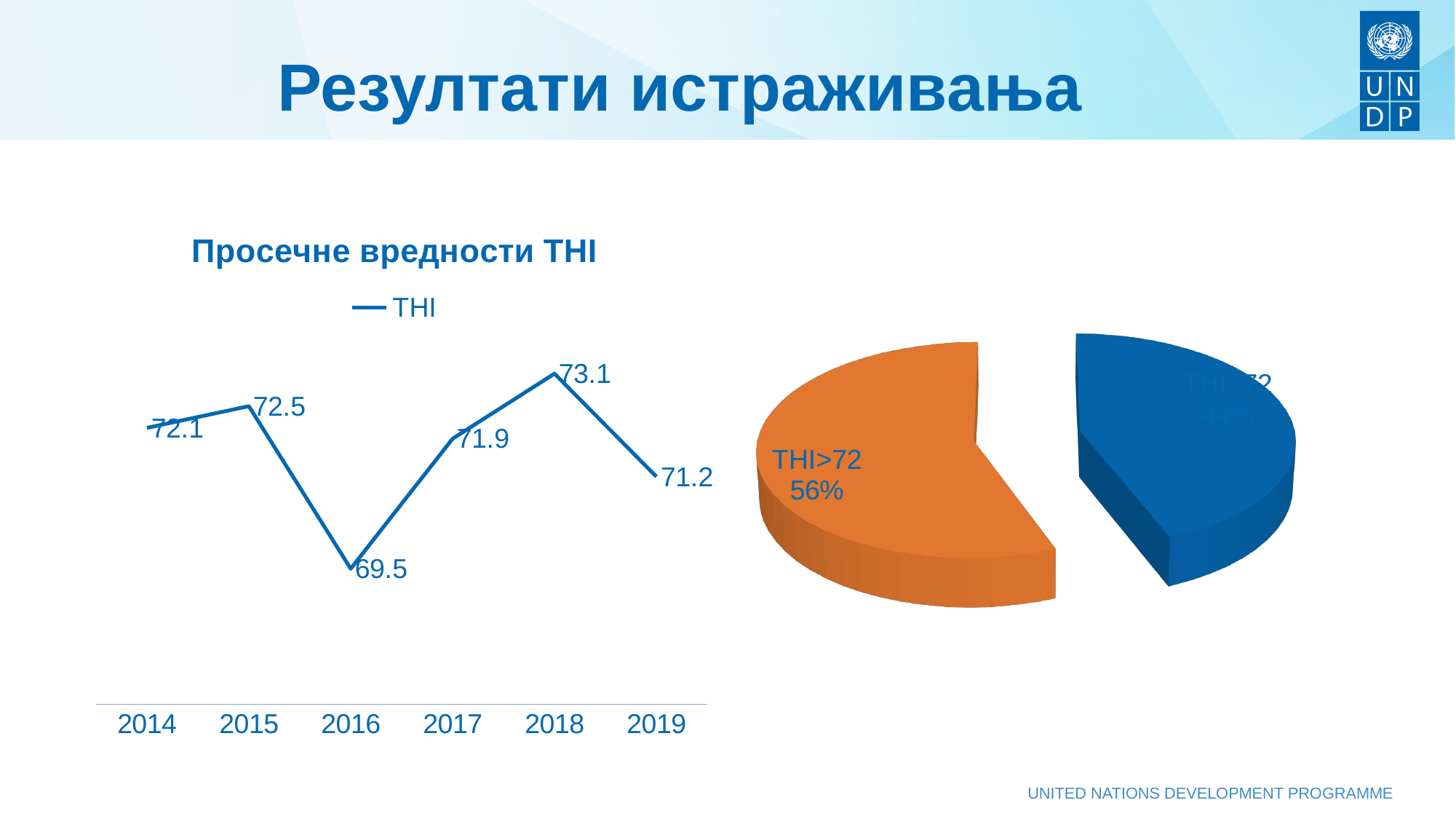
On the line chart 'Просечне вредности THI', which year has a higher THI value, 2015 or 2017? 2015 What type of chart is shown on the right side of the slide? pie chart On the line chart 'Просечне вредности THI', what is the THI value for 2019? 71.2 On the line chart 'Просечне вредности THI', what is the THI value for 2018? 73.1 On the line chart 'Просечне вредности THI', which year has the highest THI value? 2018 On the line chart 'Просечне вредности THI', how many series does the legend list? 1 On the line chart 'Просечне вредности THI', what is the difference between the THI values for 2018 and 2016? 3.6 On the line chart 'Просечне вредности THI', what is the THI value for 2016? 69.5 On the line chart 'Просечне вредности THI', does the THI value rise or fall from 2018 to 2019? fall On the pie chart on the right, what share does the 'THI>72' slice have? 56% On the line chart 'Просечне вредности THI', which year has the lowest THI value? 2016 On the line chart 'Просечне вредности THI', how many years are plotted? 6